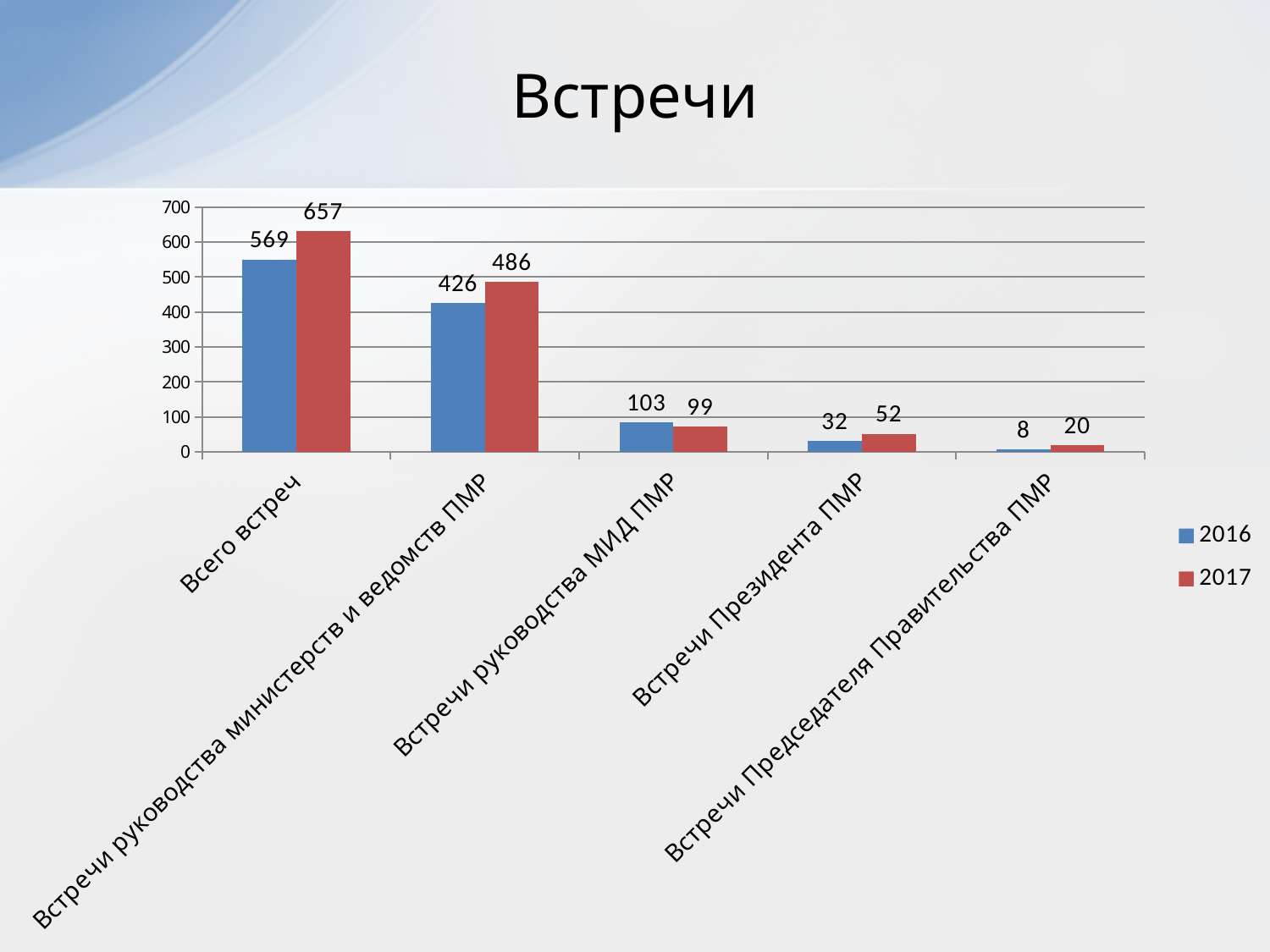
How many categories are shown on the x axis? 5 What is the difference between the 2016 and 2017 values for "Встречи руководства МИД ПМР"? 4 What is the difference between the 2017 and 2016 values for "Всего встреч"? 88 Is the 2016 value for "Всего встреч" greater or less than 500? greater Which category has the highest value for 2017? Всего встреч What is the value for 2017 for "Всего встреч"? 657 What is the value for 2016 for "Встречи руководства МИД ПМР"? 103 Which is larger for "Встречи руководства министерств и ведомств ПМР": the 2016 value or the 2017 value? 2017 What kind of chart is shown on the slide? bar chart What is the value for 2017 for "Встречи Президента ПМР"? 52 Which category has the lowest value for 2016? Встречи Председателя Правительства ПМР How many series does the legend list? 2